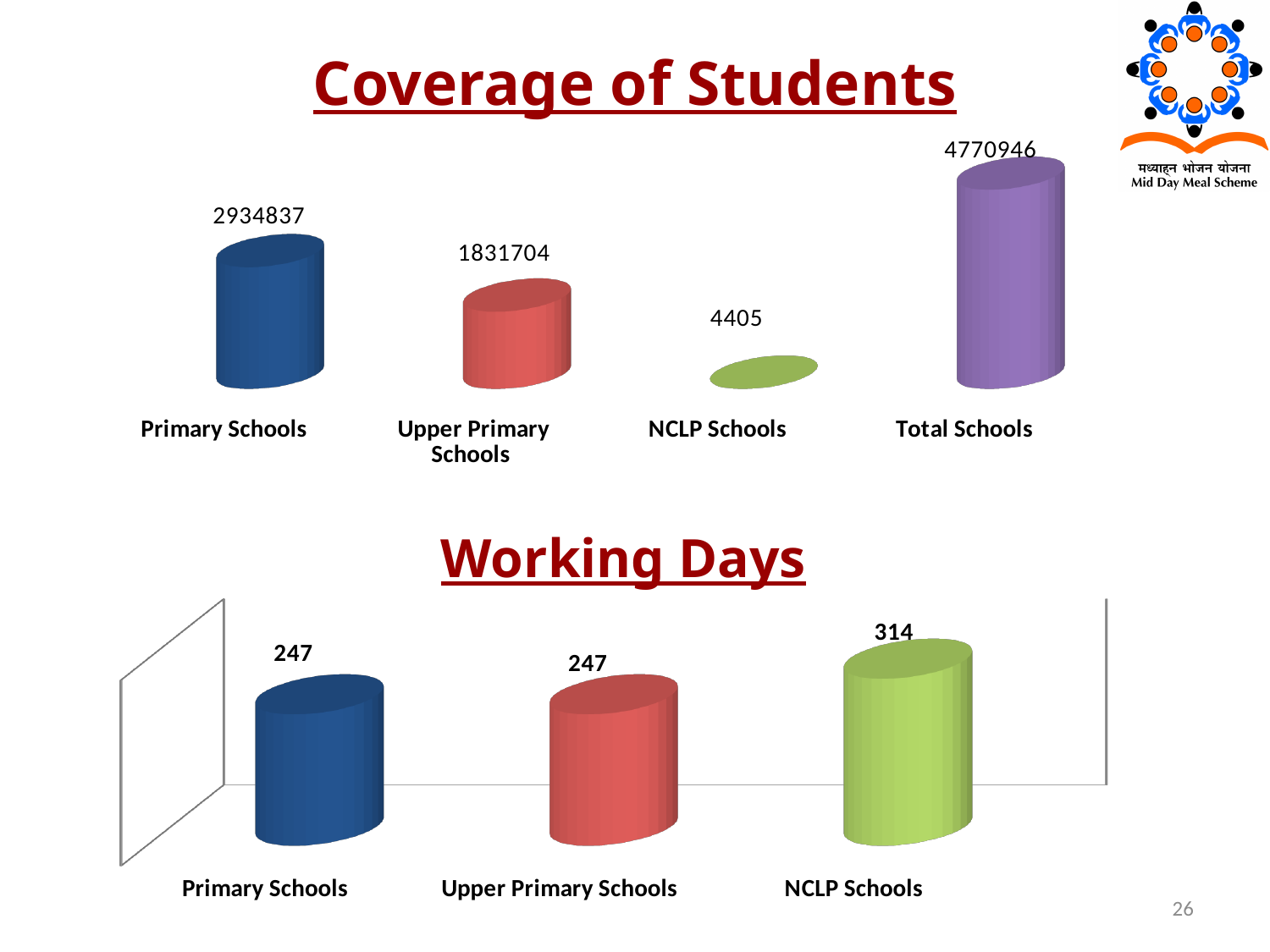
In the Coverage of Students chart, how many categories are shown? 4 In the Working Days chart, what is the value for Primary Schools? 247 In the Coverage of Students chart, which category has the highest value? Total Schools In the Coverage of Students chart, what is the value for NCLP Schools? 4405 In the Working Days chart, what is the value for NCLP Schools? 314 In the Coverage of Students chart, what is the difference between Primary Schools and Upper Primary Schools? 1103133 In the Coverage of Students chart, which category has the lowest value? NCLP Schools In the Coverage of Students chart, what is the value for Upper Primary Schools? 1831704 What kind of chart is the Working Days chart? Bar chart In the Working Days chart, which category has the highest value? NCLP Schools In the Coverage of Students chart, what is the value for Primary Schools? 2934837 In the Working Days chart, what is the difference between NCLP Schools and Upper Primary Schools? 67